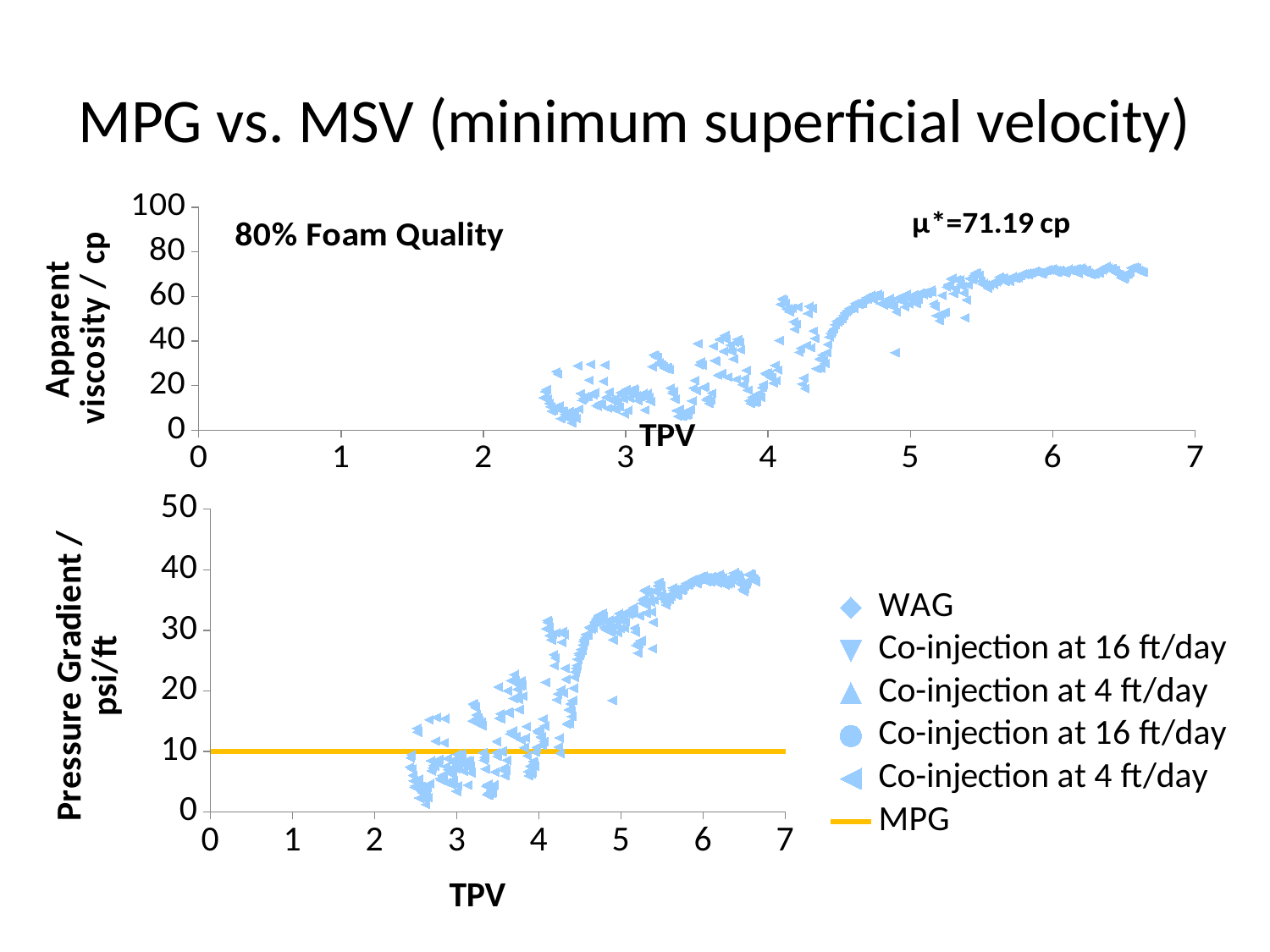
On the bottom chart (Pressure Gradient), are the values plotted near TPV = 2.5 greater or less than 20? less What is the maximum value shown on the x axis of the bottom chart (Pressure Gradient)? 7 On the bottom chart (Pressure Gradient), do the plotted values generally rise or fall as TPV increases? rise What value of μ* is annotated on the top chart (Apparent viscosity)? μ*=71.19 cp On the top chart (Apparent viscosity), are the values plotted near TPV = 6 greater or less than 60? greater What foam quality is annotated on the top chart (Apparent viscosity)? 80% Foam Quality On the bottom chart (Pressure Gradient), are the values plotted near TPV = 6 greater or less than 30? greater What kind of chart is the top chart (Apparent viscosity vs TPV)? scatter chart On the bottom chart (Pressure Gradient), at what value on the y axis is the MPG line drawn? 10 On the top chart (Apparent viscosity), do the plotted values generally rise or fall as TPV increases? rise How many entries does the legend on the bottom chart (Pressure Gradient) list? 6